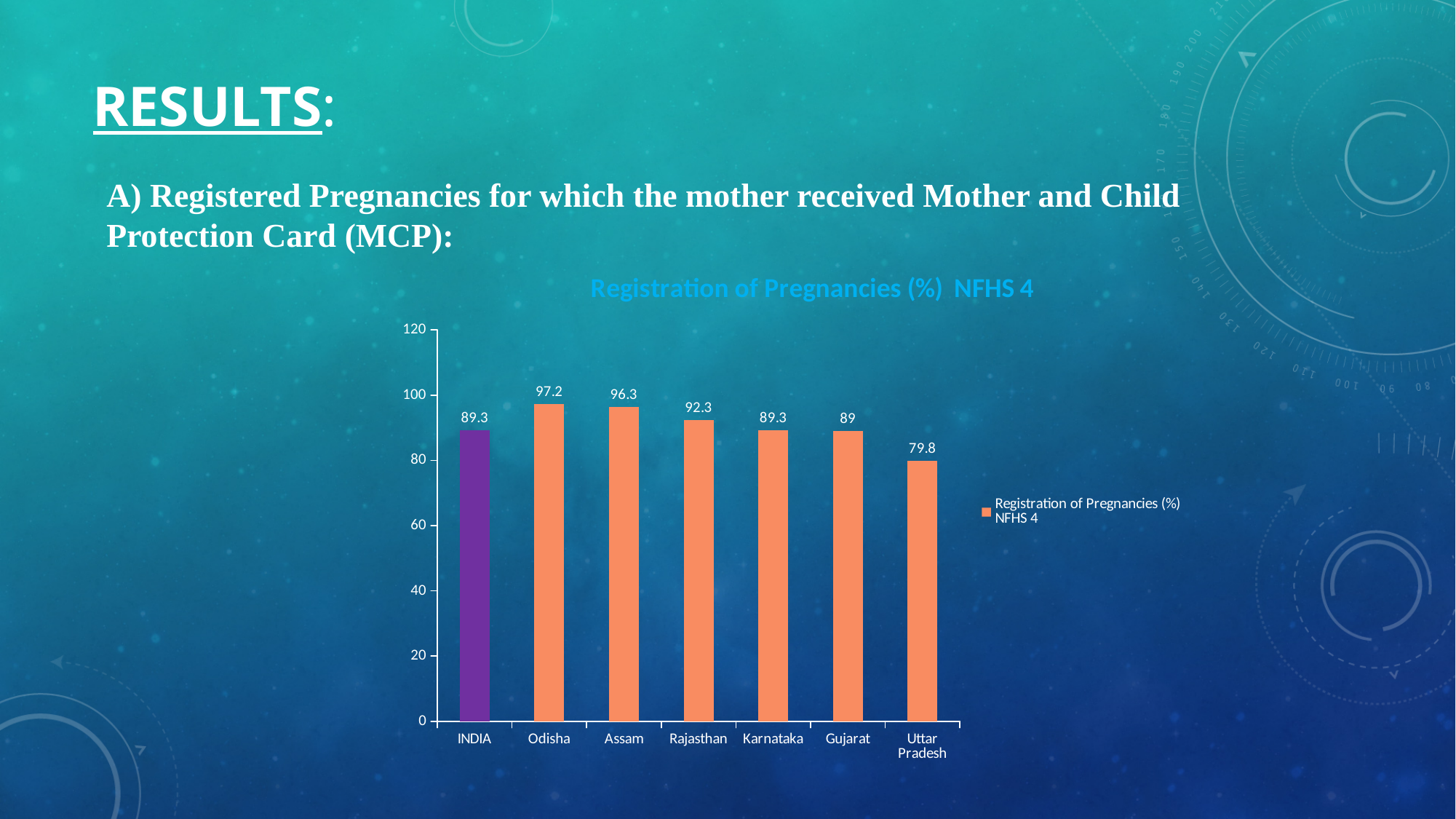
What kind of chart is shown on the slide? Bar chart Which category has the lowest value? Uttar Pradesh What is the value for Odisha? 97.2 Which category has the highest value? Odisha Which is larger, the value for Rajasthan or the value for Karnataka? Rajasthan How many categories are shown on the x axis? 7 What is the difference between the values for Odisha and Uttar Pradesh? 17.4 What is the value for INDIA? 89.3 What is the value for Uttar Pradesh? 79.8 What is the title of the chart? Registration of Pregnancies (%) NFHS 4 What is the value for Gujarat? 89 What is the difference between the values for Assam and Rajasthan? 4